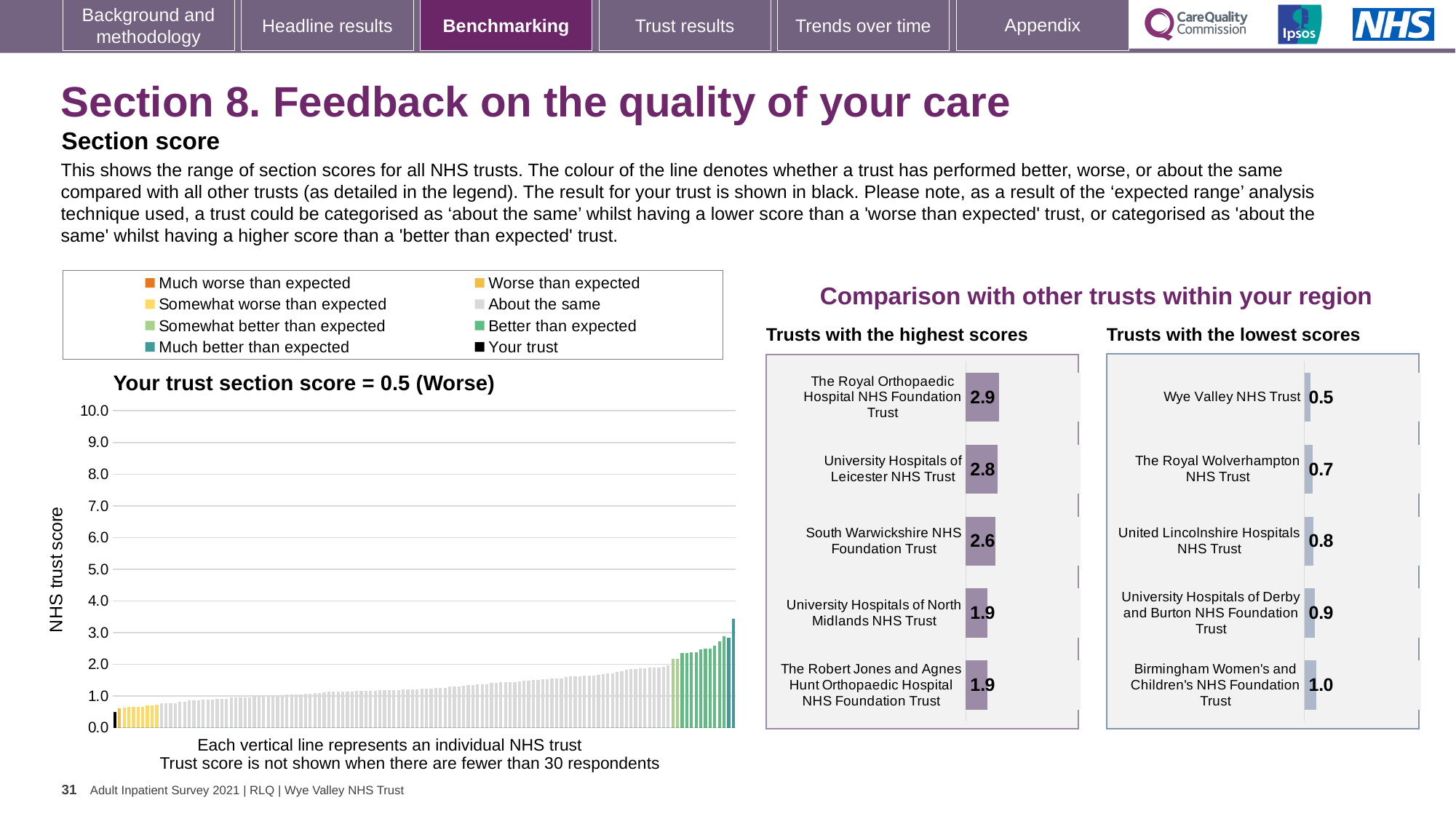
What type of chart is the 'Trusts with the highest scores' chart? Bar chart How many trusts are listed in the 'Trusts with the lowest scores' chart? 5 In the 'Trusts with the highest scores' chart, what is the score for South Warwickshire NHS Foundation Trust? 2.6 In the 'Trusts with the lowest scores' chart, which trust has the lowest score? Wye Valley NHS Trust What is the section score for your trust shown in the title of the main chart on the left? 0.5 (Worse) In the 'Trusts with the highest scores' chart, which trust has the highest score? The Royal Orthopaedic Hospital NHS Foundation Trust In the 'Trusts with the lowest scores' chart, which has the larger score: United Lincolnshire Hospitals NHS Trust or Birmingham Women's and Children's NHS Foundation Trust? Birmingham Women's and Children's NHS Foundation Trust In the main chart on the left, do the trust scores rise or fall from left to right along the x axis? Rise In the 'Trusts with the highest scores' chart, what is the score for The Royal Orthopaedic Hospital NHS Foundation Trust? 2.9 In the 'Trusts with the lowest scores' chart, what is the score for The Royal Wolverhampton NHS Trust? 0.7 How many entries does the legend above the main chart on the left list? 8 In the 'Trusts with the highest scores' chart, what is the difference between the scores of The Royal Orthopaedic Hospital NHS Foundation Trust and University Hospitals of North Midlands NHS Trust? 1.0